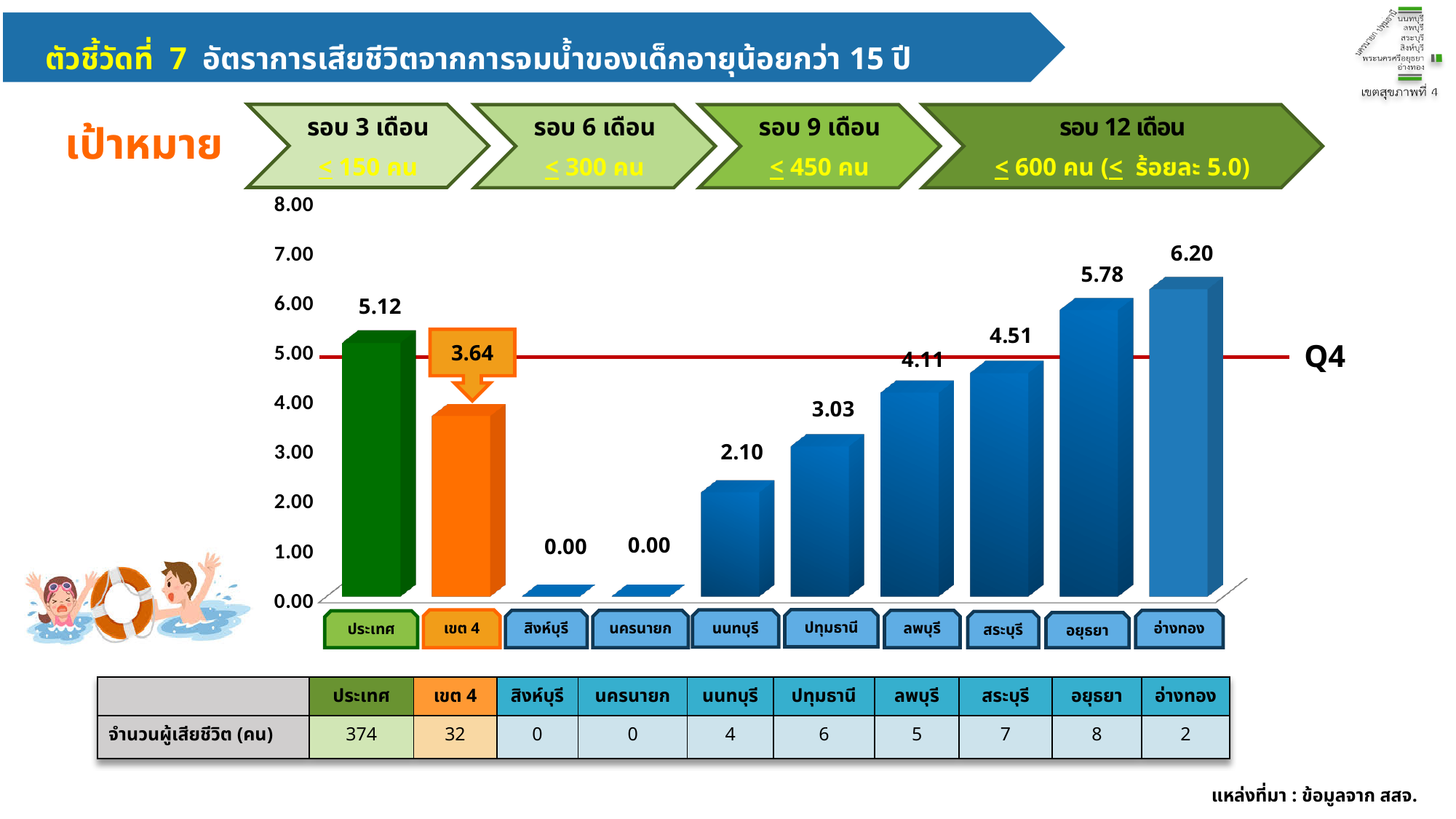
At what value on the y axis is the red horizontal line labelled Q4 drawn? 5.00 What is the value shown for อ่างทอง in the bar chart? 6.20 What is the value shown for ปทุมธานี in the bar chart? 3.03 What is the value shown for ประเทศ in the bar chart? 5.12 What is the difference between the values for อ่างทอง and อยุธยา? 0.42 What kind of chart is shown on the slide? bar chart Which category has the highest value in the bar chart? อ่างทอง What is the difference between the values for ประเทศ and เขต 4? 1.48 Which has a larger value, สระบุรี or ลพบุรี? สระบุรี What is the value shown for เขต 4 in the bar chart? 3.64 Which categories have the lowest value in the bar chart? สิงห์บุรี and นครนายก How many categories are plotted in the bar chart? 10